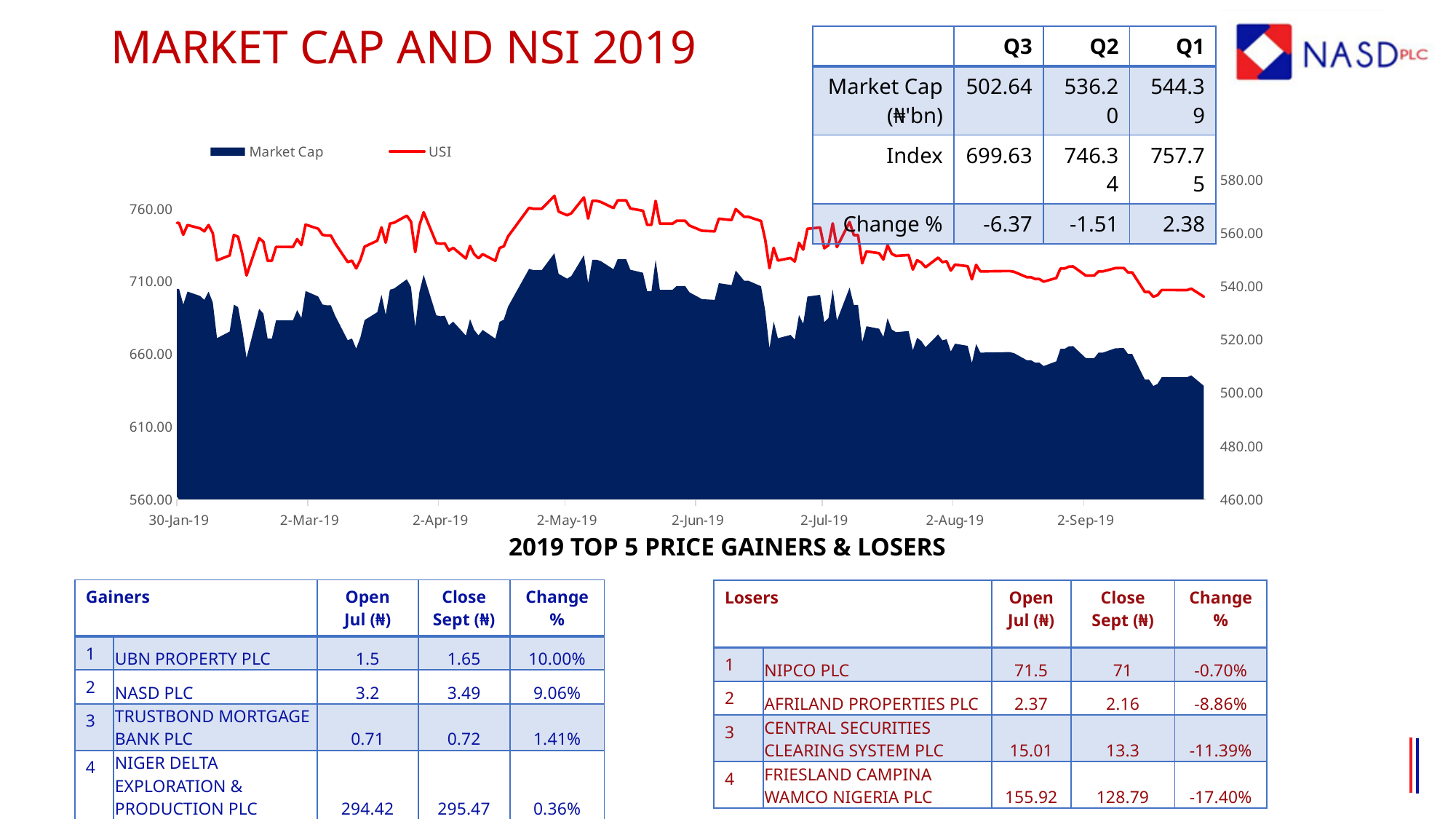
What kind of chart is shown on the slide? An area chart with a line overlaid Is the USI value at 30-Jan-19 greater or less than 710 on the left axis? greater How many date labels are shown on the x axis of the chart? 8 Overall, does the USI line rise or fall from 30-Jan-19 to the end of the chart? Fall Is the USI value at the end of the chart (after 2-Sep-19) greater or less than 660 on the left axis? greater What are the two series named in the chart legend? Market Cap and USI Is the Market Cap value at the end of the chart (after 2-Sep-19) greater or less than 520 on the right axis? less What is the last date label on the x axis of the chart? 2-Sep-19 What is the first date label on the x axis of the chart? 30-Jan-19 How many series does the chart legend list? 2 What colour is the USI series on the chart? Red Overall, does the Market Cap area rise or fall from 30-Jan-19 to the end of the chart? Fall